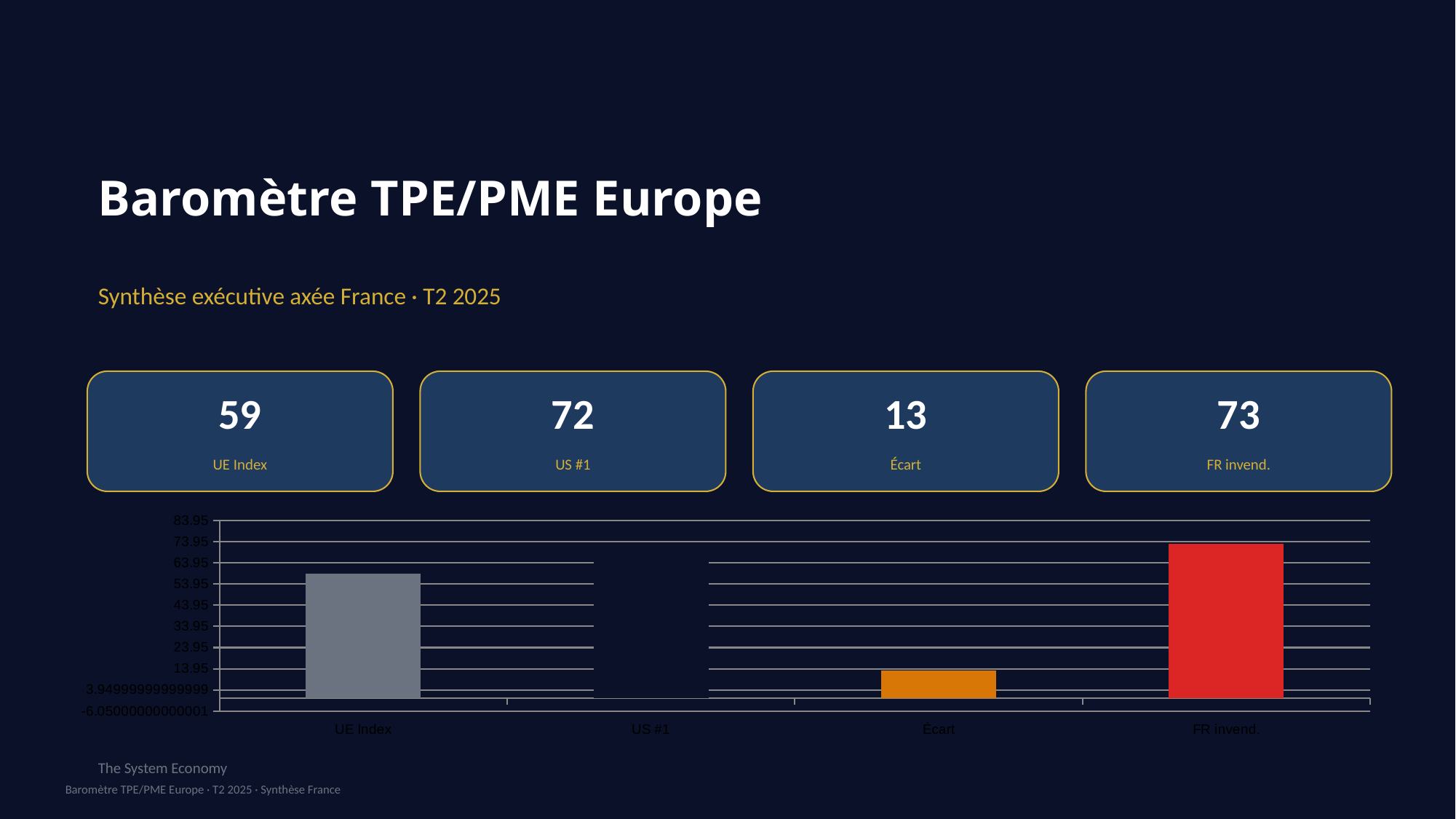
What is the value for FR invend.? 73 Is the bar for Écart greater or less than 23.95 on the y axis? less Which is larger, the value for FR invend. or the value for UE Index? FR invend. What is the difference between the values for UE Index and Écart? 46 What is the value shown for US #1? 72 What colour is the bar for FR invend.? red Is the bar for UE Index greater or less than 43.95 on the y axis? greater Which is larger, the value for UE Index or the value for Écart? UE Index How many categories are shown on the x axis of the chart? 4 What is the value for UE Index? 59 What kind of chart is shown on the slide? bar chart What is the value for Écart? 13